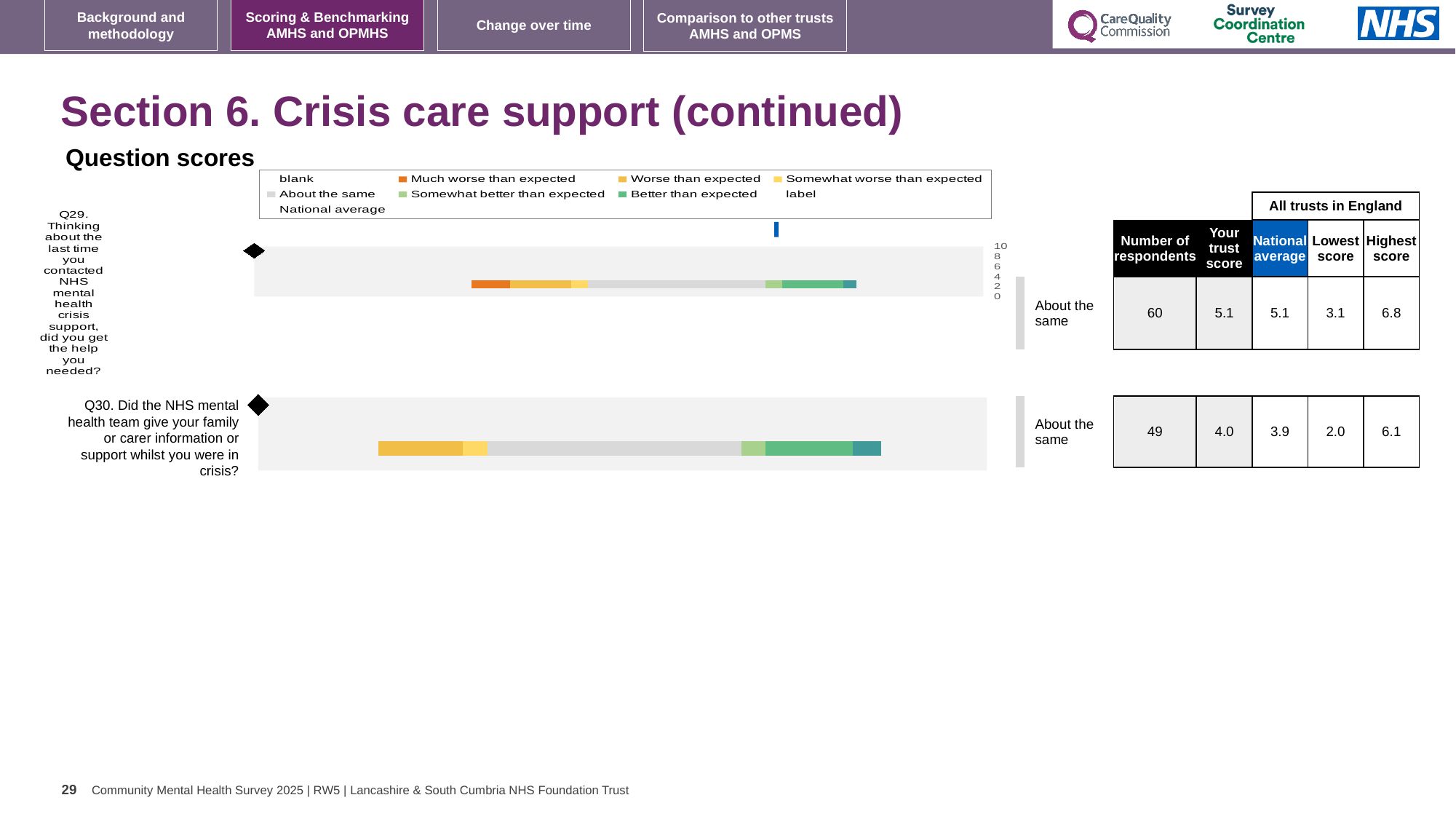
What is the trust score for Q29 shown in the table? 5.1 What benchmark category is shown next to the Q29 bar? About the same What kind of chart is used to show the Q29 and Q30 question scores? bar chart For Q30, which is larger: the trust score or the national average? trust score What is the highest score across all trusts in England for Q30? 6.1 What is the difference between the trust score and the lowest score for Q30? 2.0 Which legend entry is shown in orange? Much worse than expected What is the national average for Q30? 3.9 Which question has more respondents, Q29 or Q30? Q29 What is the difference between the highest score and the lowest score for Q29? 3.7 How many respondents answered Q30? 49 How many questions are plotted as bars on the slide? 2